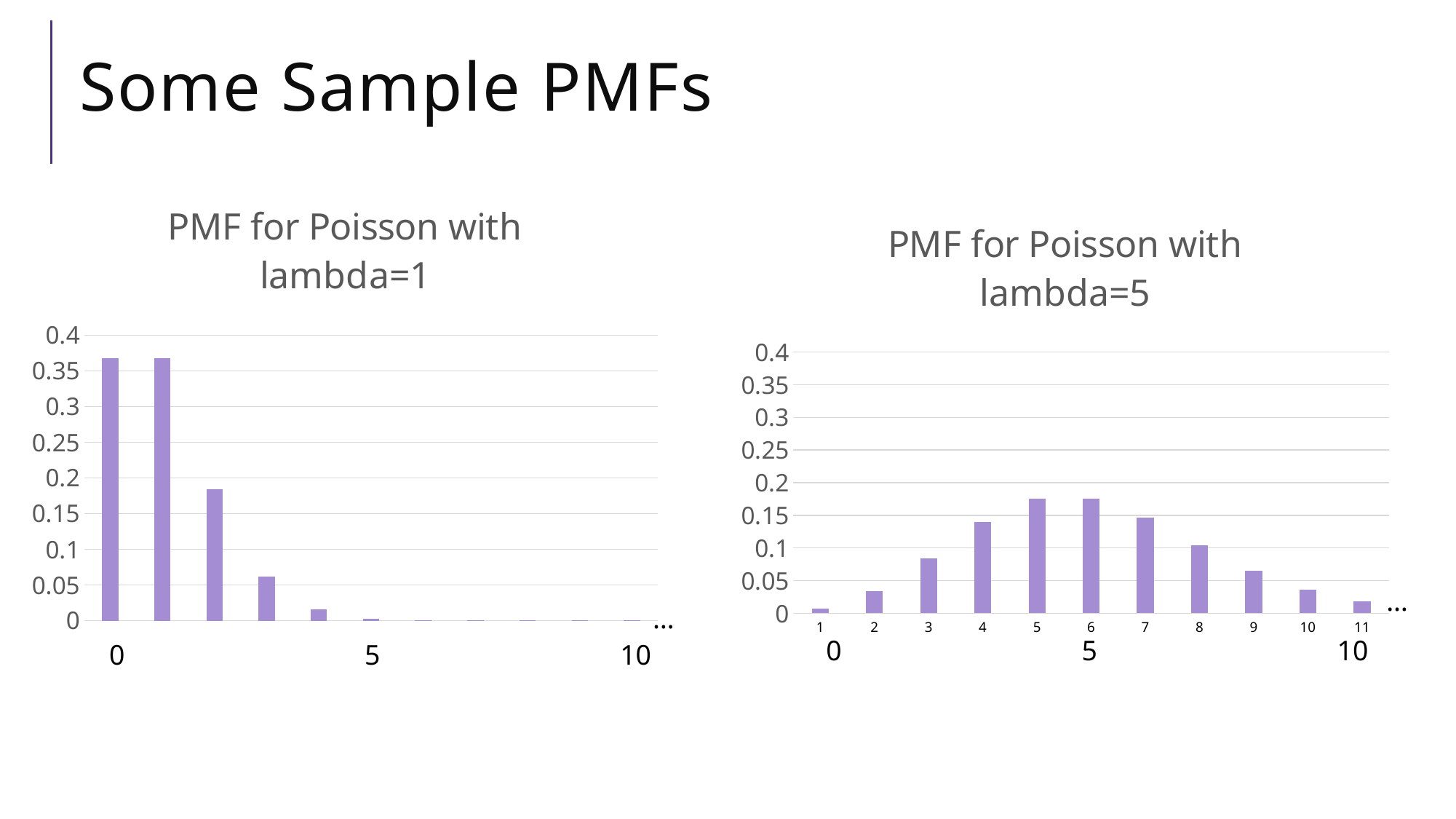
In the 'PMF for Poisson with lambda=5' chart, is the value for category 3 greater or less than 0.1? less In the 'PMF for Poisson with lambda=5' chart, is the value for category 5 greater or less than 0.15? greater In the 'PMF for Poisson with lambda=5' chart, which category has the lowest value? 1 In the 'PMF for Poisson with lambda=1' chart, is the value for 2 greater or less than 0.2? less How many bars are plotted in the 'PMF for Poisson with lambda=5' chart? 11 In the 'PMF for Poisson with lambda=1' chart, which is larger, the value for 2 or the value for 3? 2 In the 'PMF for Poisson with lambda=1' chart, do the values rise or fall as you move right along the x axis? fall What is the title of the chart on the right side of the slide? PMF for Poisson with lambda=5 What kind of chart is the 'PMF for Poisson with lambda=1' chart? bar chart In the 'PMF for Poisson with lambda=5' chart, which is larger, the value for category 4 or the value for category 9? 4